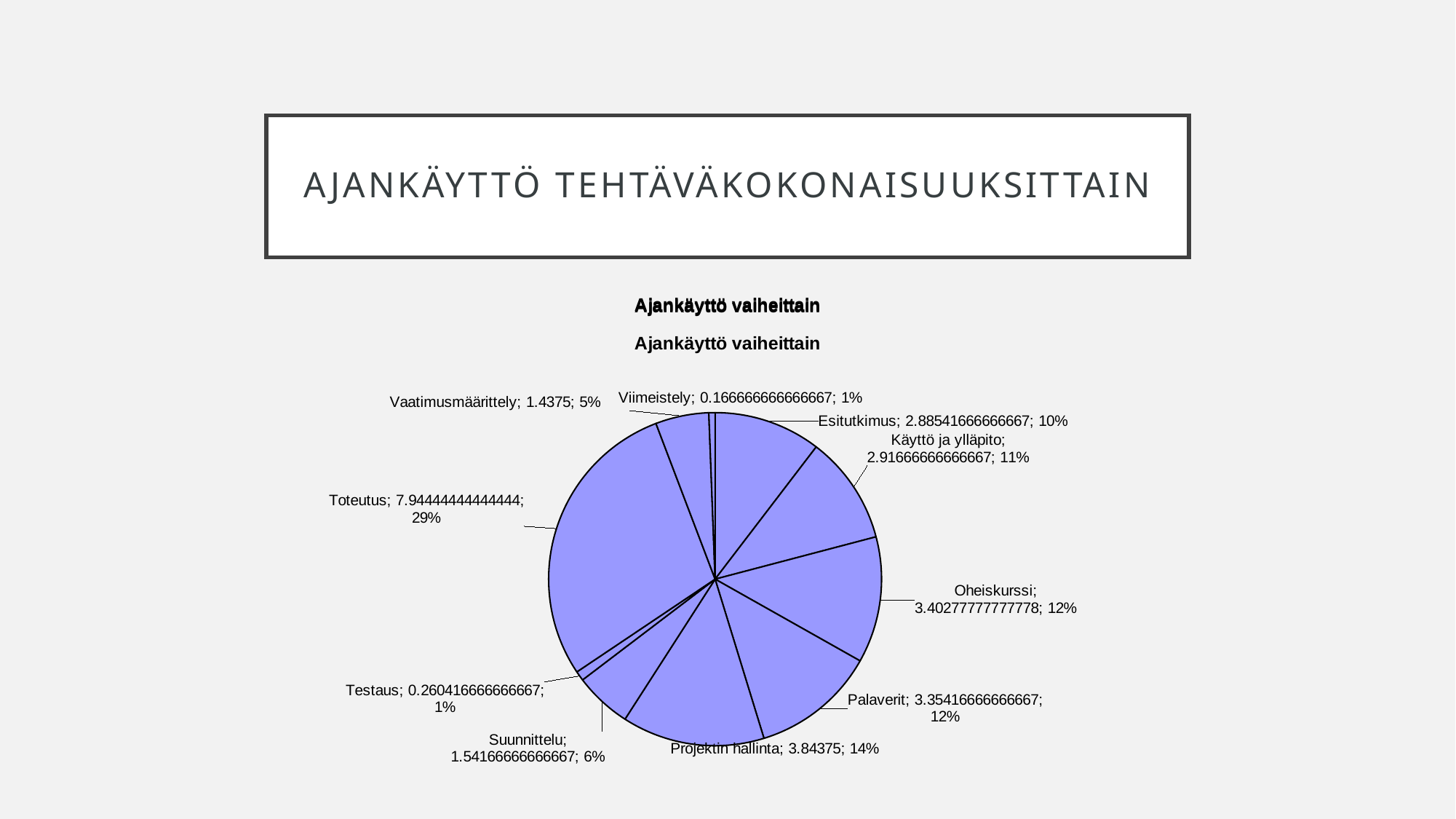
Which category has the smallest value in the pie chart? Viimeistely What value is shown for Vaatimusmäärittely? 1.4375 What is the difference between the values for Projektin hallinta and Vaatimusmäärittely? 2.40625 Which is larger, the value for Oheiskurssi or the value for Palaverit? Oheiskurssi What percentage share does Suunnittelu have in the pie chart? 6% How many slices does the pie chart have? 10 What percentage share does Esitutkimus have in the pie chart? 10% What value is shown for Projektin hallinta? 3.84375 What kind of chart is shown on the slide? pie chart Which category has the largest slice of the pie? Toteutus What is the title of the chart? Ajankäyttö vaiheittain What percentage share does Toteutus have in the pie chart? 29%